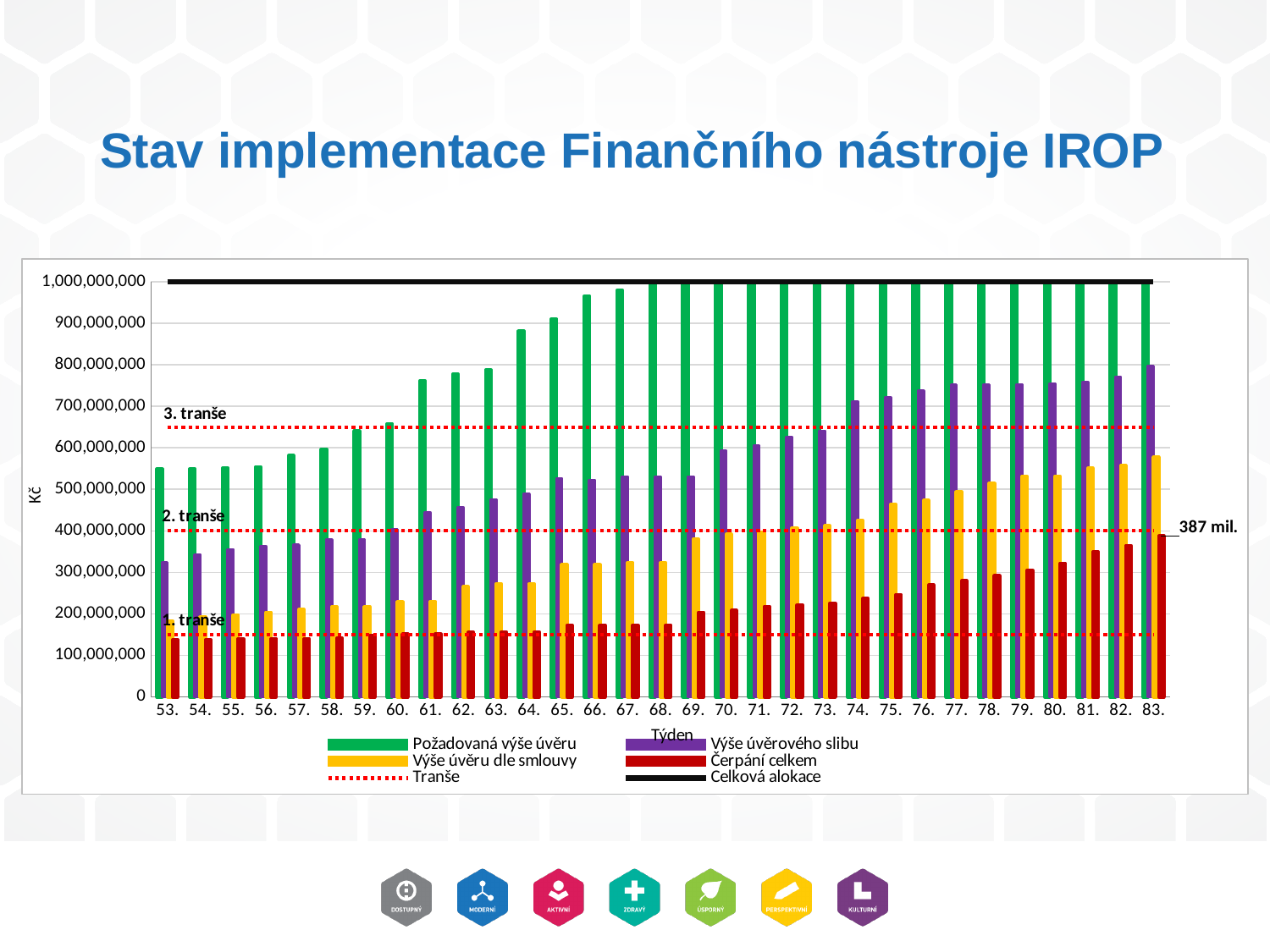
What is the title of the slide? Stav implementace Finančního nástroje IROP How many weeks (categories) are shown on the x axis? 31 At what value does the Celková alokace line sit on the y axis? 1,000,000,000 Is the value of Čerpání celkem in week 53 greater or less than 200,000,000? less Which week has the highest value of Čerpání celkem? 83. What kind of chart is shown on the slide? combination bar and line chart What is the labelled value of Čerpání celkem in week 83? 387 mil. Is the value of Požadovaná výše úvěru in week 53 greater or less than 500,000,000? greater In week 83, which is larger: Výše úvěrového slibu or Výše úvěru dle smlouvy? Výše úvěrového slibu Do the Čerpání celkem values rise or fall from week 53 to week 83? rise How many series does the chart legend list? 6 Is the value of Výše úvěrového slibu in week 70 greater or less than 500,000,000? greater